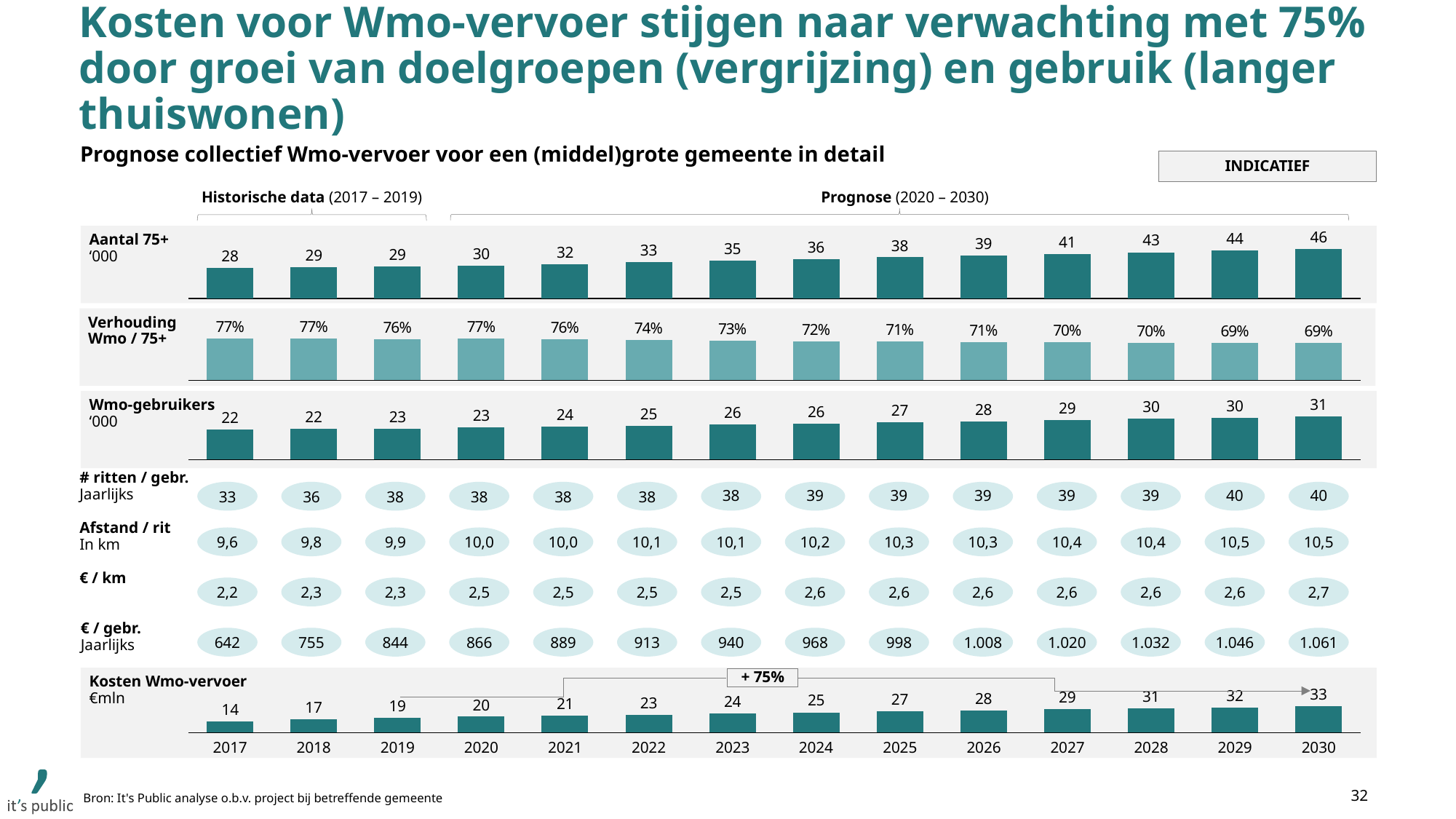
How many years are shown on the x axis of the "Kosten Wmo-vervoer" chart? 14 In the "Verhouding Wmo / 75+" chart, which year has the lowest value among the historical years 2017–2019? 2019 In the "Kosten Wmo-vervoer" chart, which year has the highest value? 2030 In the "Wmo-gebruikers" chart, what is the value for 2025? 27 What kind of chart is the "Kosten Wmo-vervoer" chart? bar chart In the "Verhouding Wmo / 75+" chart, do the values rise or fall from 2020 to 2030? fall In the "Kosten Wmo-vervoer" chart, what is the value for 2017? 14 In the "Wmo-gebruikers" chart, is the value for 2019 larger or smaller than the value for 2029? smaller In the "Verhouding Wmo / 75+" chart, what is the value for 2022? 74% In the "Aantal 75+" chart, what is the value for 2030? 46 In the "Kosten Wmo-vervoer" chart, what is the difference between the values for 2030 and 2017? 19 In the "Aantal 75+" chart, what is the difference between the values for 2030 and 2020? 16